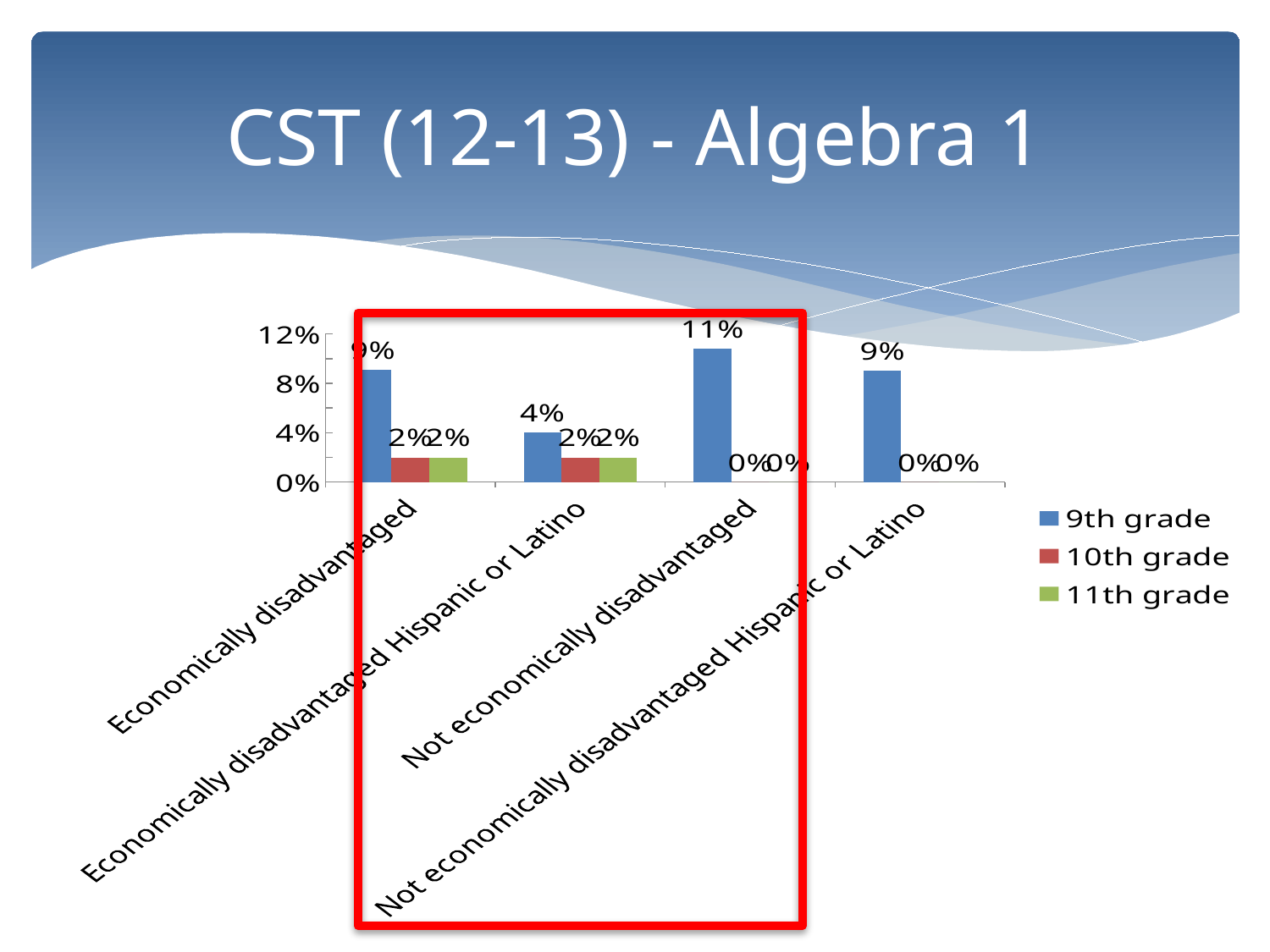
Which is larger: the 9th grade value for Economically disadvantaged or for Economically disadvantaged Hispanic or Latino? Economically disadvantaged What kind of chart is shown on the slide? Bar chart What is the 9th grade value for Not economically disadvantaged? 11% What is the 9th grade value for Economically disadvantaged? 9% Which category has the highest 9th grade value? Not economically disadvantaged Which category has the lowest 9th grade value? Economically disadvantaged Hispanic or Latino How many categories are shown on the x axis? 4 What is the 9th grade value for Economically disadvantaged Hispanic or Latino? 4% What is the 10th grade value for Not economically disadvantaged Hispanic or Latino? 0% How many series does the legend list? 3 What is the difference between the 9th grade values for Not economically disadvantaged and Economically disadvantaged Hispanic or Latino? 7% What is the 11th grade value for Economically disadvantaged? 2%